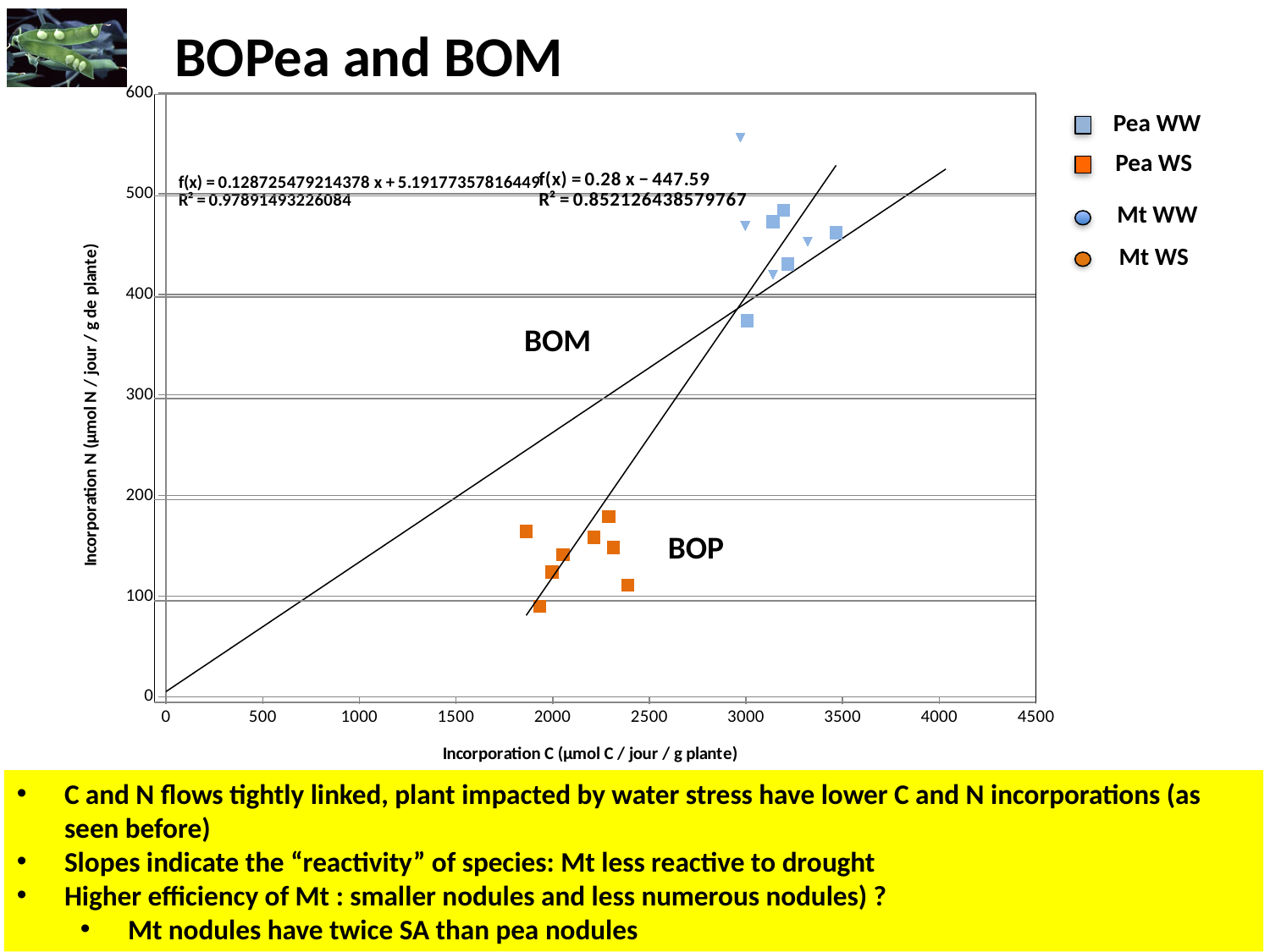
What is the title of the chart? BOPea and BOM Are the Incorporation C values for the Pea WW points greater or less than 2500? greater What is the R² value printed for the trendline with equation f(x) = 0.128725479214378 x + 5.19177357816449? 0.97891493226084 How many series does the legend list? 4 Which series has higher Incorporation N values, Pea WW or Pea WS? Pea WW Do the Incorporation N values rise or fall as Incorporation C increases along the x axis? rise Are the Incorporation N values for the Pea WW points greater or less than 300? greater What kind of chart is shown on the slide? Scatter chart What is the label of the x axis? Incorporation C (µmol C / jour / g plante) Are the Incorporation N values for the Pea WS points greater or less than 200? less What is the R² value printed for the trendline with equation f(x) = 0.28 x − 447.59? 0.852126438579767